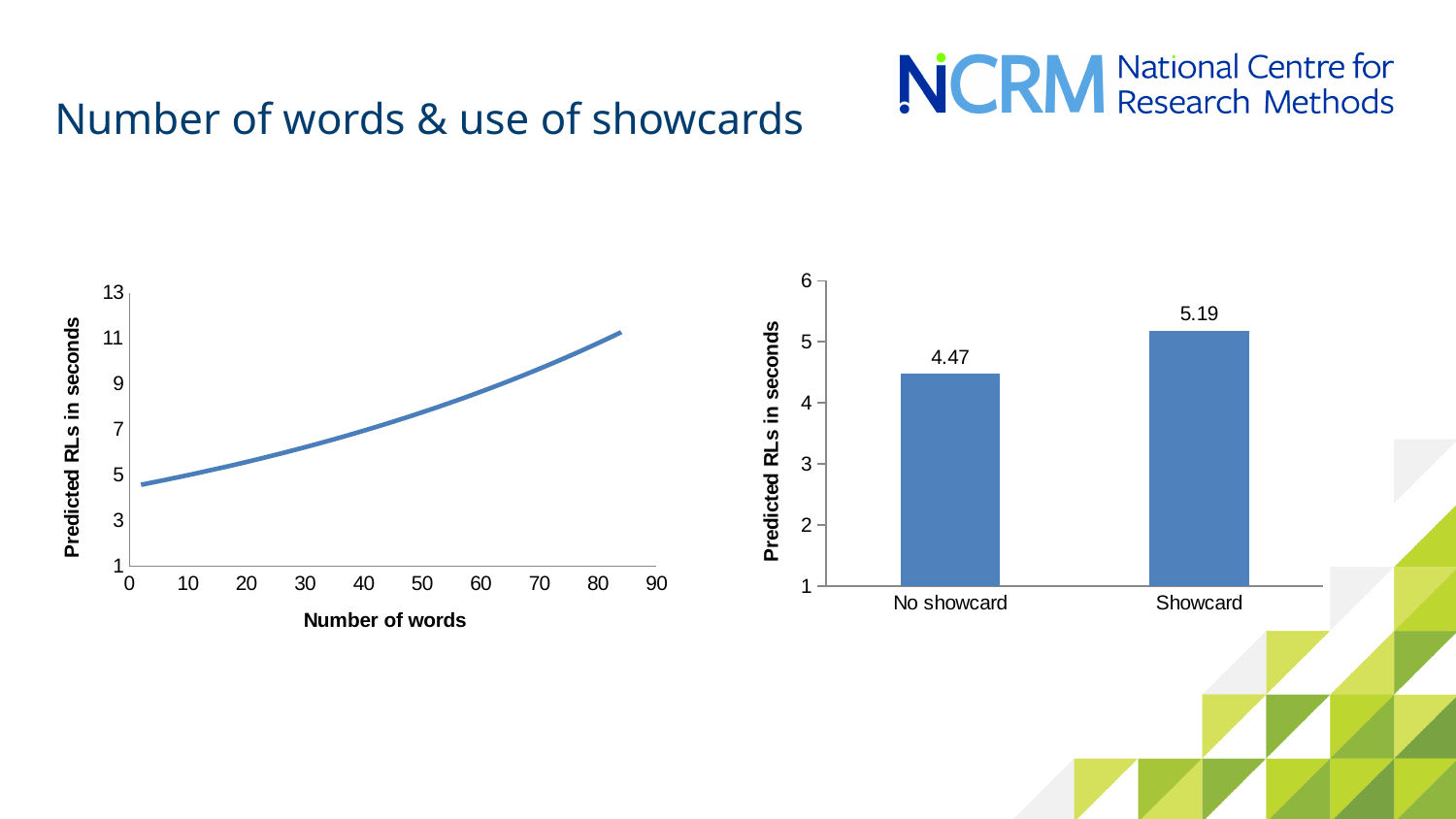
In the bar chart on the right, is the value for No showcard greater or less than 5? less In the bar chart on the right, what is the predicted RLs in seconds for No showcard? 4.47 In the bar chart on the right, what is the difference in predicted RLs between Showcard and No showcard? 0.72 In the bar chart on the right, how many categories are shown? 2 What kind of chart is the chart on the left? line chart What kind of chart is the chart on the right? bar chart In the bar chart on the right, which category has the higher predicted RLs? Showcard What is the x-axis label of the line chart on the left? Number of words In the line chart on the left, do predicted RLs rise or fall as the number of words increases? rise In the line chart on the left, is the predicted RLs value at 80 words greater or less than 9? greater In the bar chart on the right, which category has the lower predicted RLs? No showcard In the bar chart on the right, what is the predicted RLs in seconds for Showcard? 5.19